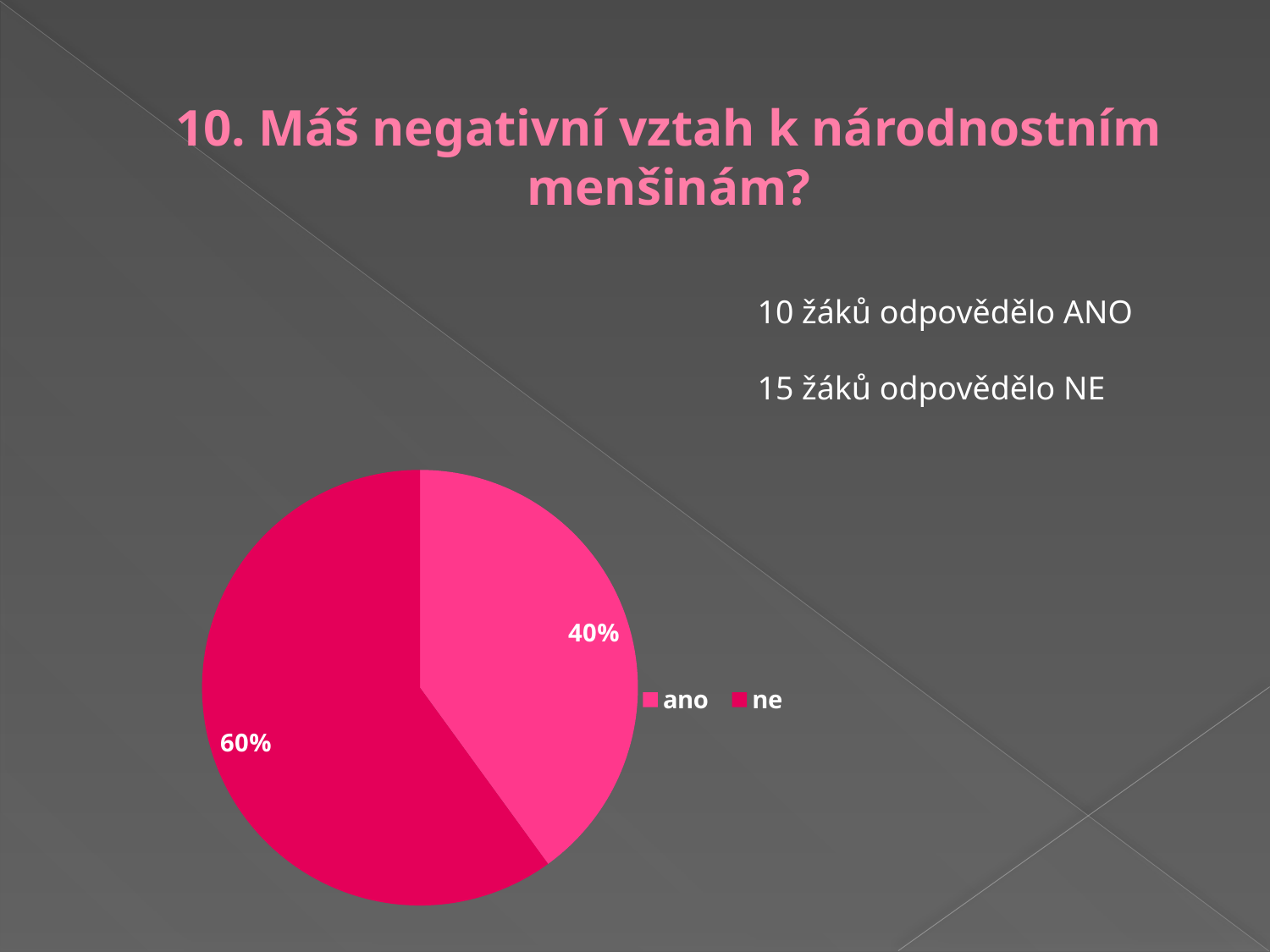
What is the title of the slide containing the pie chart? 10. Máš negativní vztah k národnostním menšinám? What share of the pie does the "ne" slice represent? 60% What is the difference in percentage points between the "ne" slice and the "ano" slice? 20% Which legend entry is shown in the lighter pink colour? ano Is the share for "ne" greater or less than 50%? greater Which slice of the pie is the smallest? ano Which is larger, the "ano" slice or the "ne" slice? ne How many entries does the legend list? 2 What share of the pie does the "ano" slice represent? 40% What kind of chart is shown on the slide? pie chart Which slice of the pie is the largest? ne How many slices does the pie chart have? 2